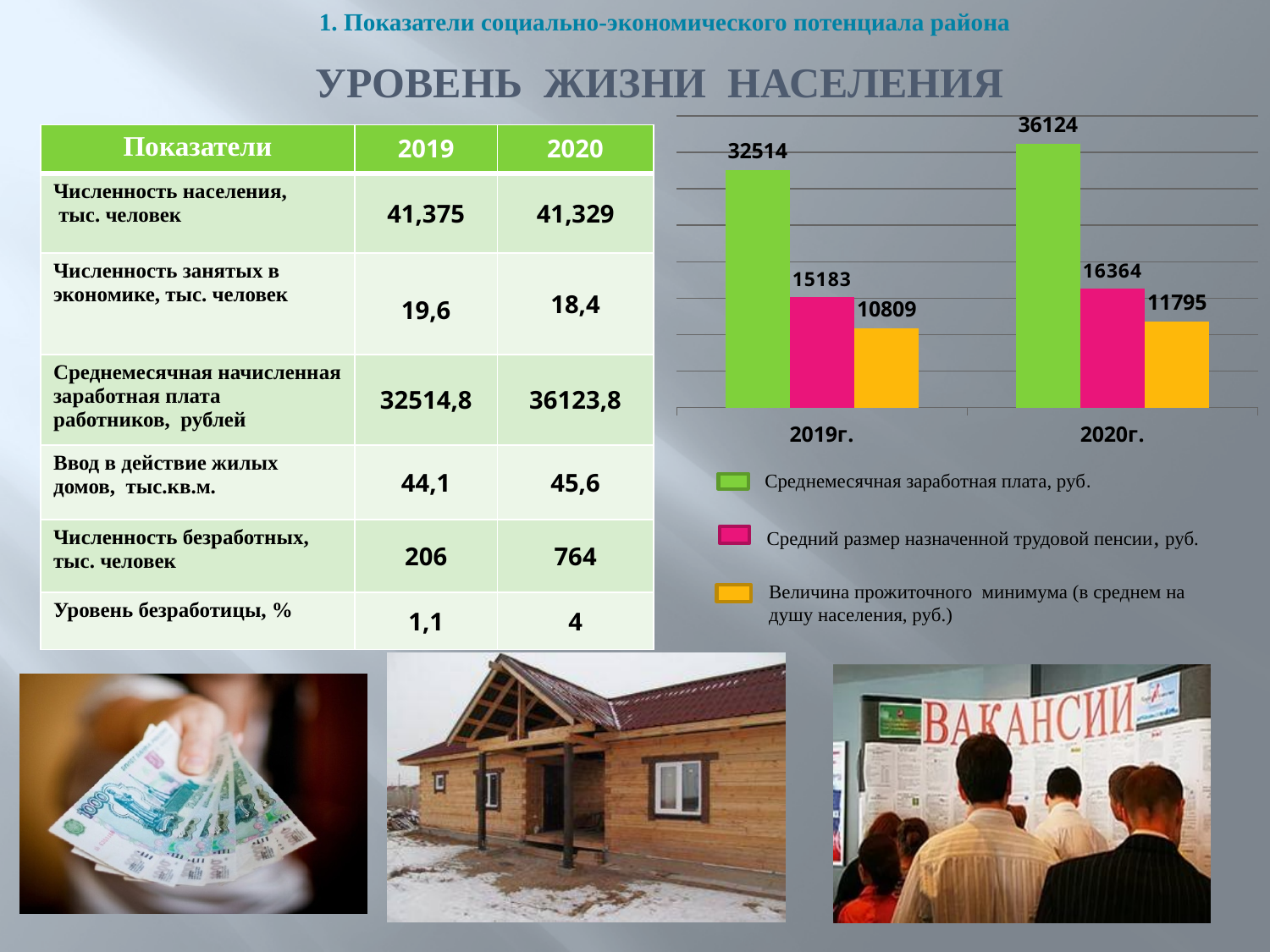
What is the difference between the average pension and the subsistence minimum in 2020г. in the chart? 4569 Which colour represents the average monthly wage series in the chart? green How many year categories are shown on the x axis of the chart? 2 What is the subsistence minimum (Величина прожиточного минимума) for 2020г. in the chart? 11795 By how much did the average monthly wage increase from 2019г. to 2020г. according to the chart? 3610 What is the average assigned pension (Средний размер назначенной трудовой пенсии) for 2019г. in the chart? 15183 What is the average monthly wage (Среднемесячная заработная плата) for 2019г. in the chart? 32514 How many series does the chart legend list? 3 Does the average monthly wage rise or fall from 2019г. to 2020г. in the chart? rise What is the average monthly wage (Среднемесячная заработная плата) for 2020г. in the chart? 36124 Which is larger in the chart: the subsistence minimum in 2019г. or in 2020г.? 2020г. What type of chart is shown on the slide? bar chart